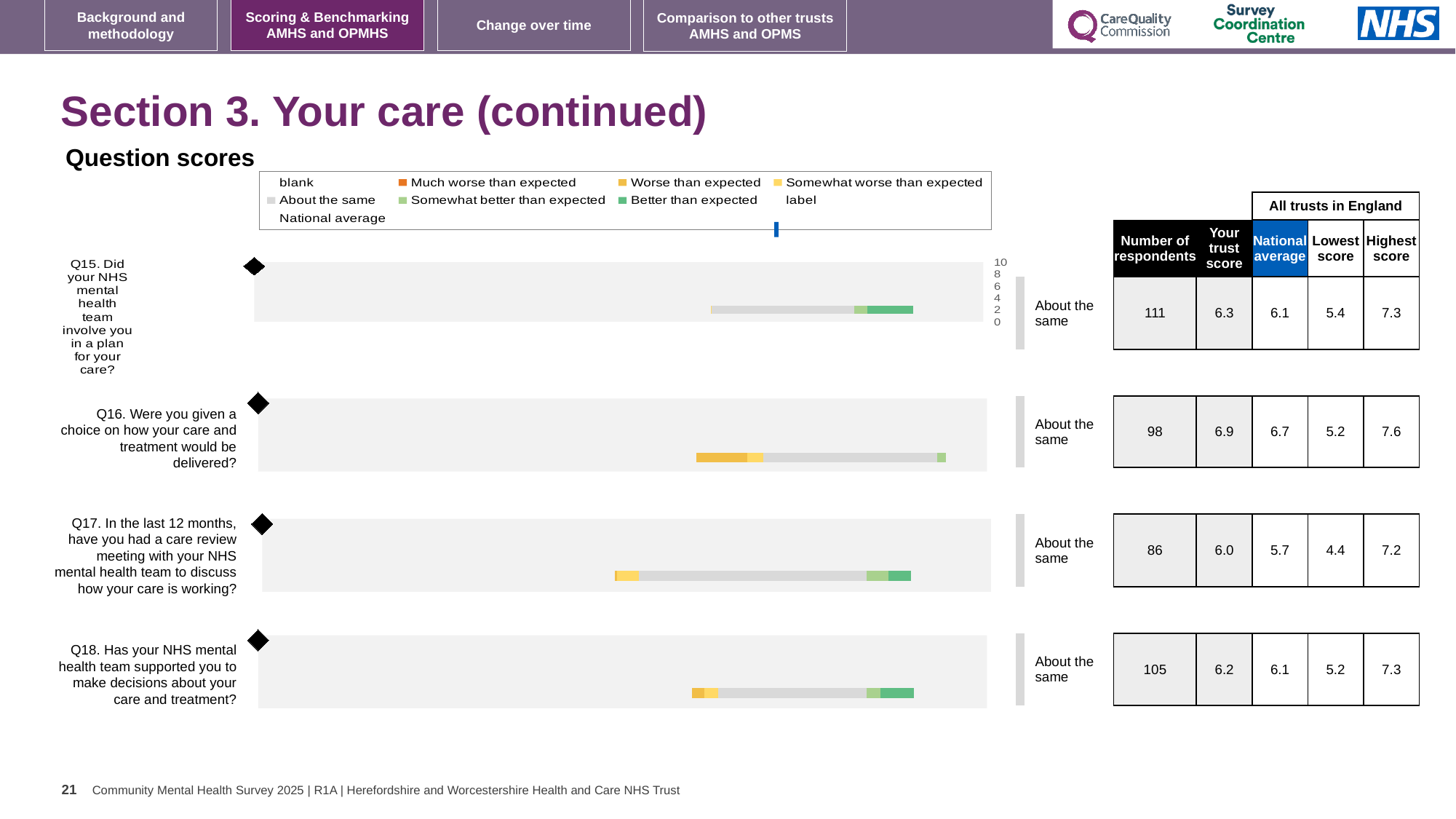
For Q15, what is the difference between the highest score (7.3) and the lowest score (5.4) among all trusts in England? 1.9 What is the 'Your trust score' value for Q16 (Were you given a choice on how your care and treatment would be delivered?)? 6.9 For Q18, which is larger: the trust score or the national average? the trust score (6.2) What benchmark category is shown next to the chart for Q17? About the same Which question has the lowest national average score on this slide? Q17 What colour does the legend use for 'Better than expected'? green How many respondents are listed for Q17 (care review meeting in the last 12 months)? 86 Which question has the highest 'Your trust score' on this slide? Q16 What kind of chart is used to show the question scores for Q15 to Q18? bar chart How many questions (Q15 to Q18) have a score chart on this slide? 4 What is the lowest score among all trusts in England for Q18? 5.2 What is the national average score for Q15 (Did your NHS mental health team involve you in a plan for your care?)? 6.1